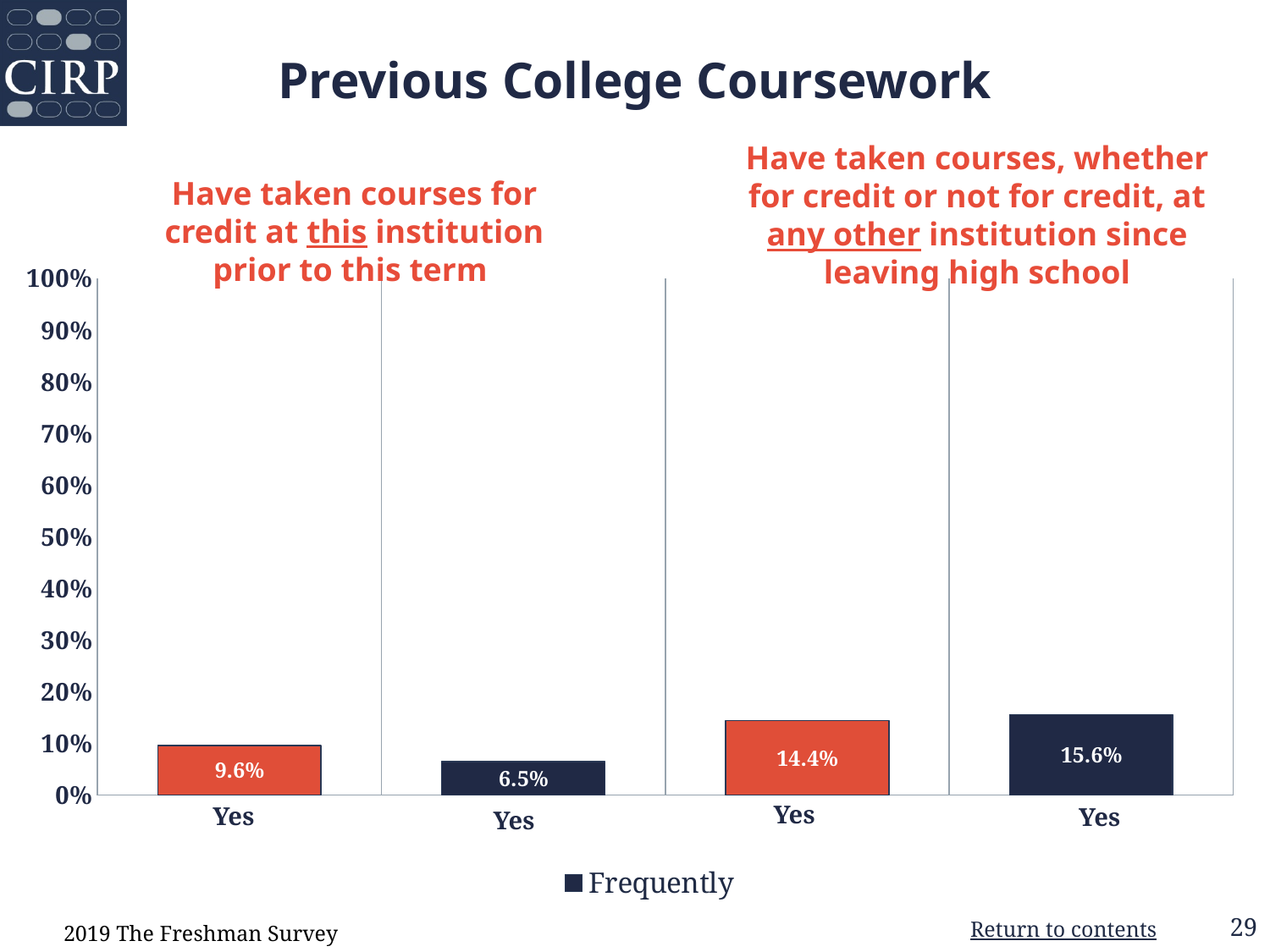
What kind of chart is shown on the slide? Bar chart What is the value of the dark navy bar under "Have taken courses, whether for credit or not for credit, at any other institution since leaving high school"? 15.6% What is the difference between the dark navy bar and the orange bar under "Have taken courses, whether for credit or not for credit, at any other institution since leaving high school"? 1.2% What is the value of the orange bar under "Have taken courses for credit at this institution prior to this term"? 9.6% What is the value of the dark navy bar under "Have taken courses for credit at this institution prior to this term"? 6.5% What is the difference between the orange bar and the dark navy bar under "Have taken courses for credit at this institution prior to this term"? 3.1% Which bar on the chart has the highest value? The dark navy bar for courses at any other institution since leaving high school (15.6%) How many bars are plotted on the chart? 4 Is the value of the dark navy bar for courses at any other institution since leaving high school greater or less than 20%? less What is the value of the orange bar under "Have taken courses, whether for credit or not for credit, at any other institution since leaving high school"? 14.4% Which is larger: the orange bar for courses at this institution prior to this term, or the orange bar for courses at any other institution since leaving high school? The orange bar for courses at any other institution since leaving high school Which bar on the chart has the lowest value? The dark navy bar for courses for credit at this institution prior to this term (6.5%)